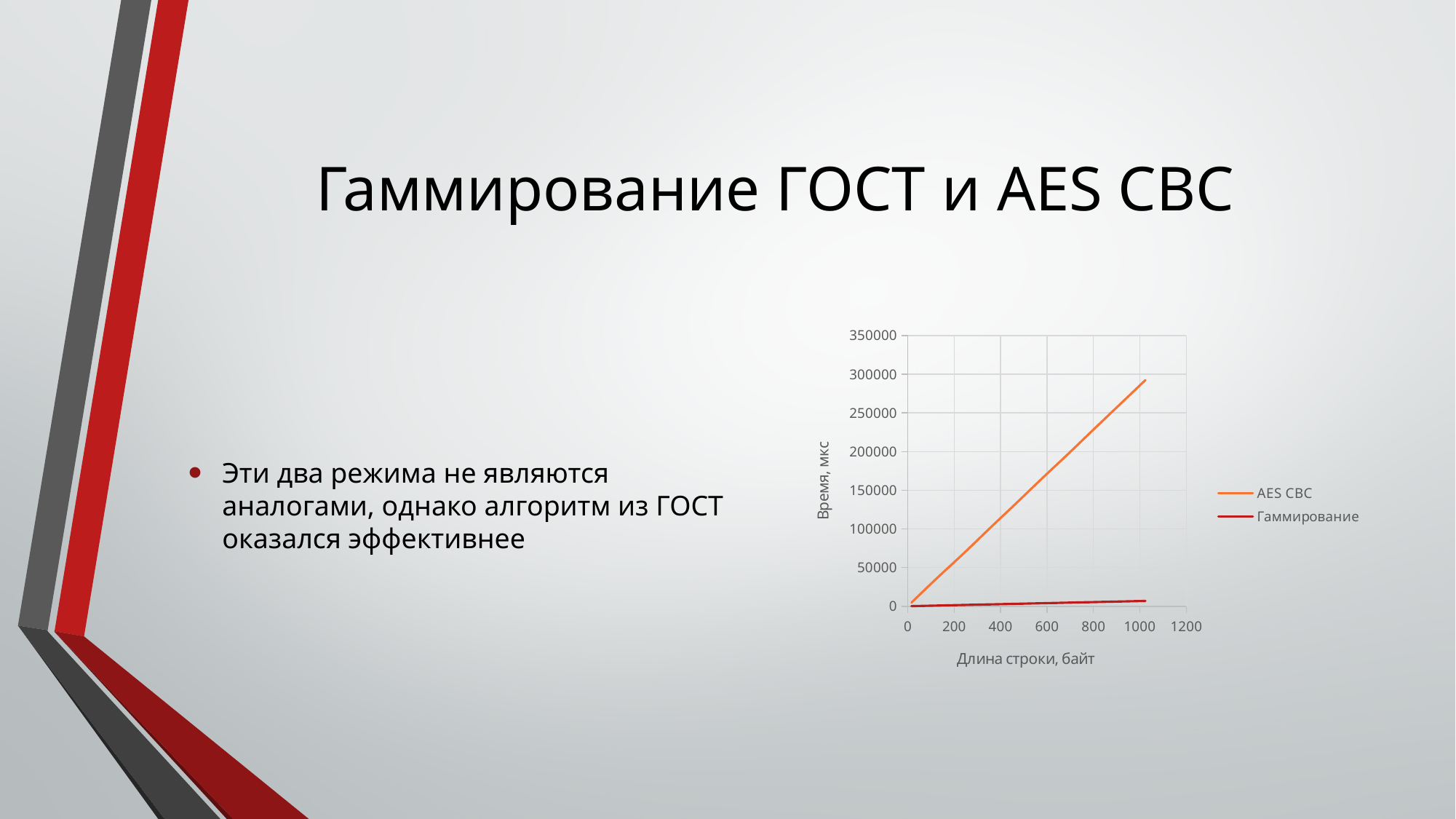
What is the maximum value shown on the chart's y axis? 350000 What kind of chart is shown on the slide? line chart Which series stays lowest across the whole range of string lengths? Гаммирование Is the AES CBC value at a string length of 1000 bytes greater or less than 300000? less Is the AES CBC value at a string length of 400 bytes greater or less than 100000? greater Which series has the higher time at a string length of 1000 bytes, AES CBC or Гаммирование? AES CBC What is the title of the chart's x axis? Длина строки, байт What are the two series named in the chart's legend? AES CBC and Гаммирование Is the AES CBC value at a string length of 1000 bytes greater or less than 250000? greater Does the AES CBC line rise or fall as the string length increases along the x axis? rise How many series does the chart's legend list? 2